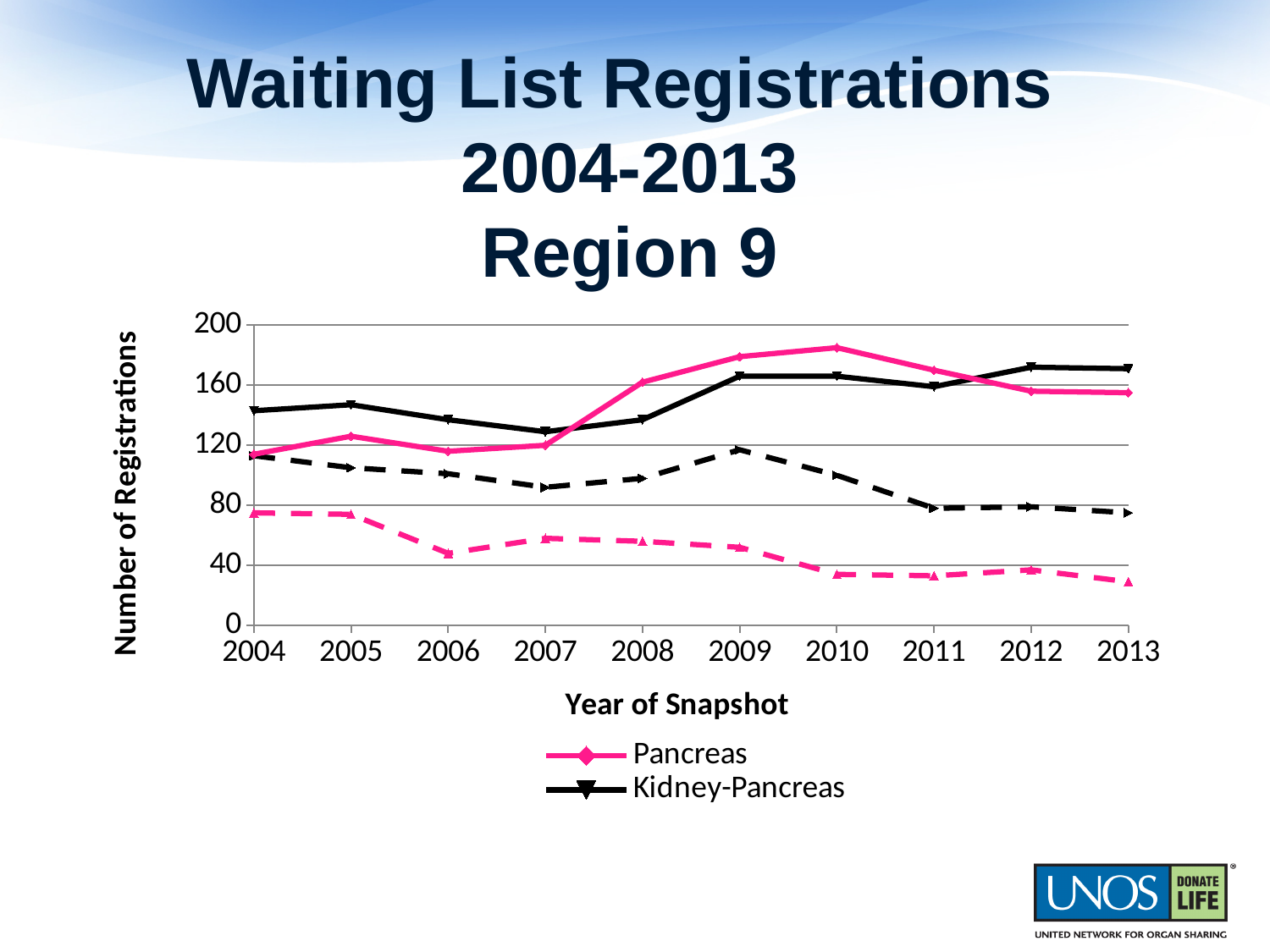
How many years are plotted along the x axis? 10 How many series does the legend list? 2 In 2010, which series has the larger value, Pancreas or Kidney-Pancreas? Pancreas What is the title of the x axis? Year of Snapshot What kind of chart is shown on the slide? line chart Does the Pancreas series rise or fall from 2007 to 2010? rise In which year does the Pancreas series reach its highest value? 2010 Is the Pancreas value for 2004 greater or less than 120? less In 2004, which series has the larger value, Pancreas or Kidney-Pancreas? Kidney-Pancreas Is the Kidney-Pancreas value for 2007 greater or less than 160? less In which year does the Kidney-Pancreas series reach its lowest value? 2007 Is the Pancreas value for 2010 greater or less than 160? greater